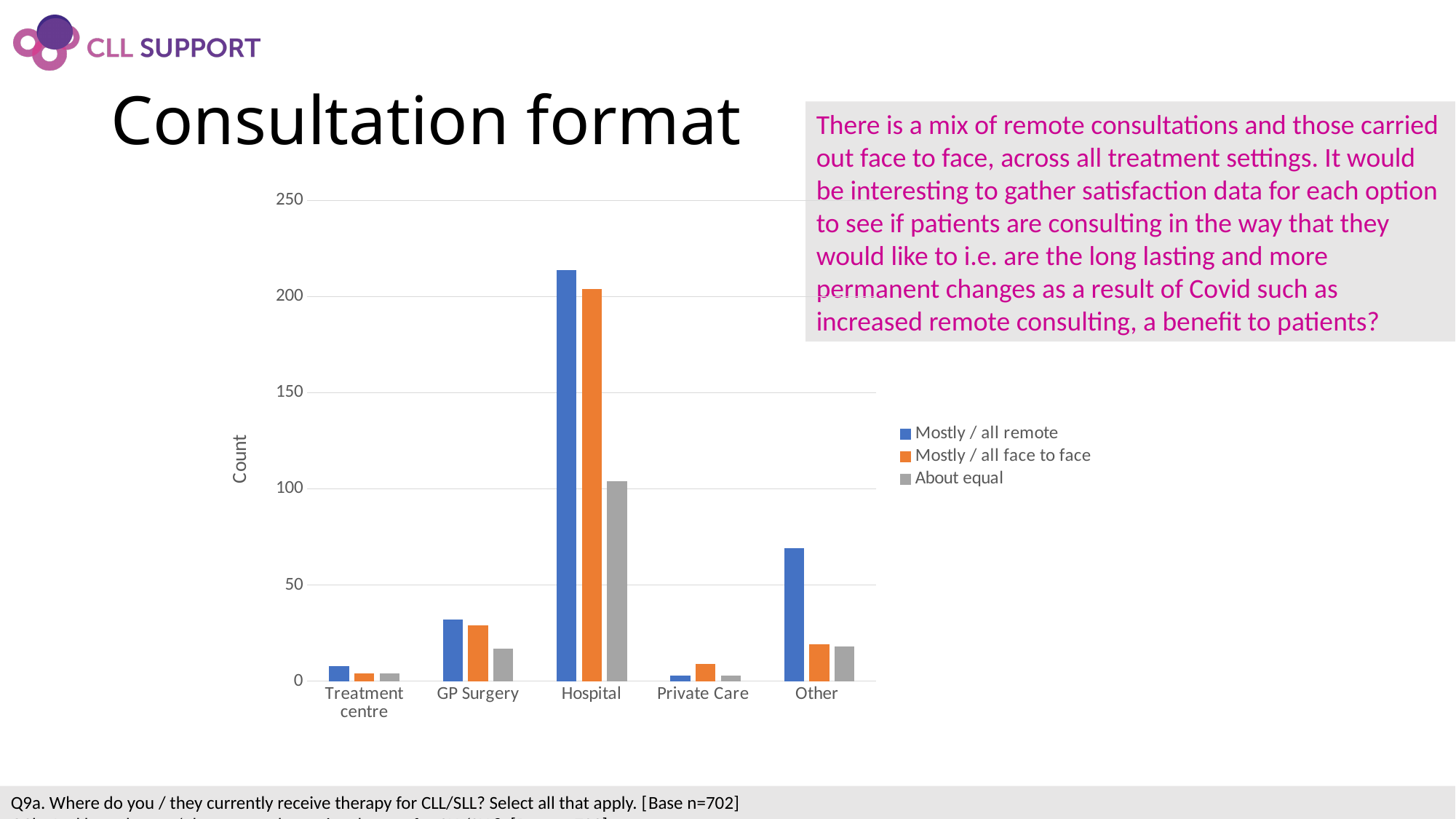
Which is larger at Private Care: Mostly / all remote or Mostly / all face to face? Mostly / all face to face Which is larger at Other: Mostly / all remote or Mostly / all face to face? Mostly / all remote How many categories are shown on the x axis? 5 What kind of chart is shown on the slide? bar chart What is the label on the y axis of the chart? Count How many series does the legend list? 3 Is the value for Mostly / all remote at Other greater or less than 50? greater Which category has the lowest value for Mostly / all remote? Private Care Which category has the highest value for Mostly / all remote? Hospital Which category has the highest value for About equal? Hospital Is the value for About equal at Hospital greater or less than 150? less Is the value for Mostly / all remote at Hospital greater or less than 200? greater